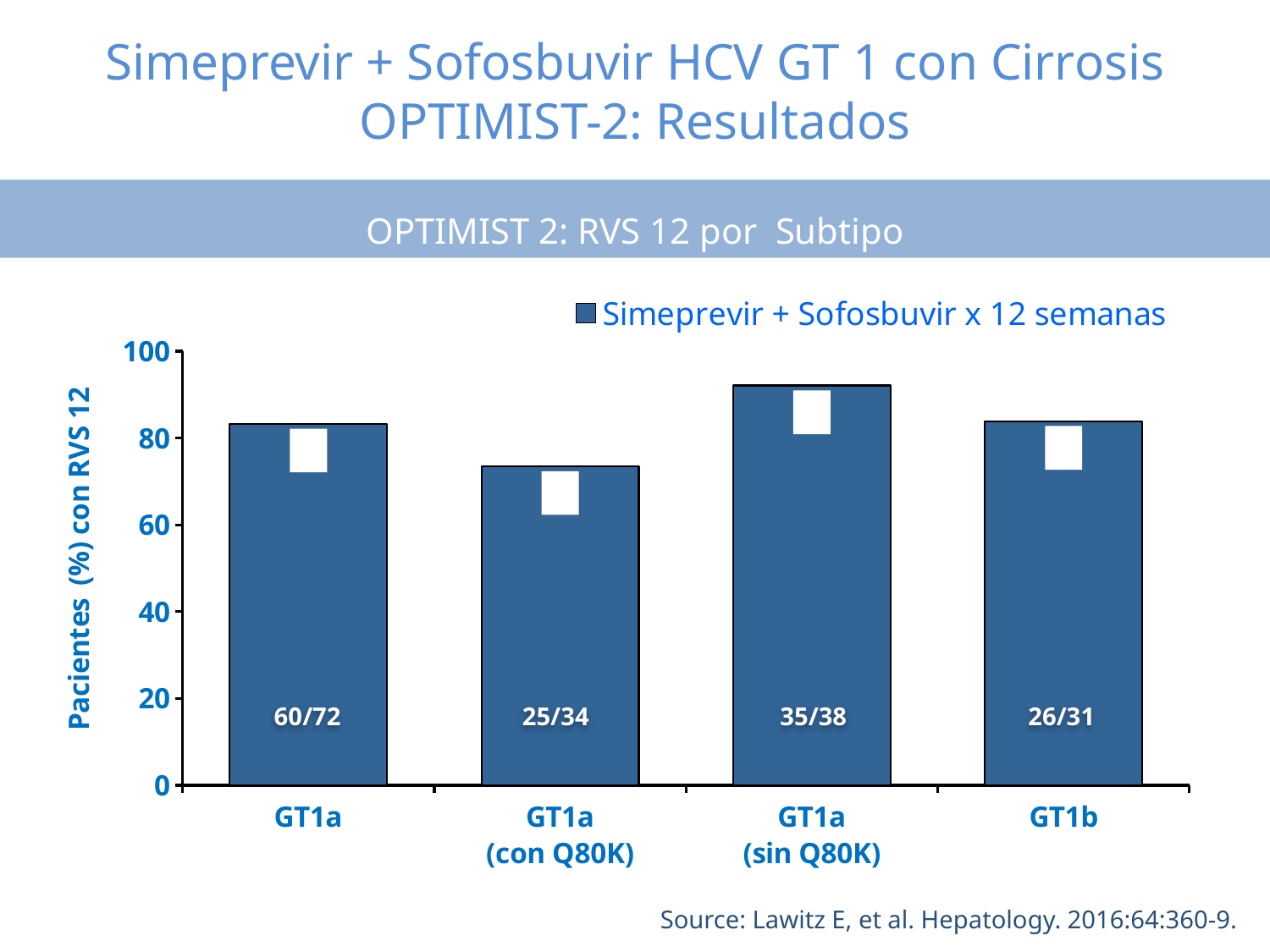
Which subtype has the lowest percentage of patients with RVS 12? GT1a (con Q80K) Is the value for GT1a (con Q80K) greater or less than 80? less How many subtype categories are shown on the x axis? 4 What label is printed on the bar for GT1a (con Q80K)? 25/34 Which subtype has the highest percentage of patients with RVS 12? GT1a (sin Q80K) What label is printed on the bar for GT1b? 26/31 Is the value for GT1a (sin Q80K) greater or less than 80? greater What label is printed on the bar for GT1a? 60/72 What label is printed on the bar for GT1a (sin Q80K)? 35/38 What kind of chart is shown on the slide? Bar chart Which is larger, the value for GT1a or the value for GT1a (con Q80K)? GT1a How many series does the legend list? 1